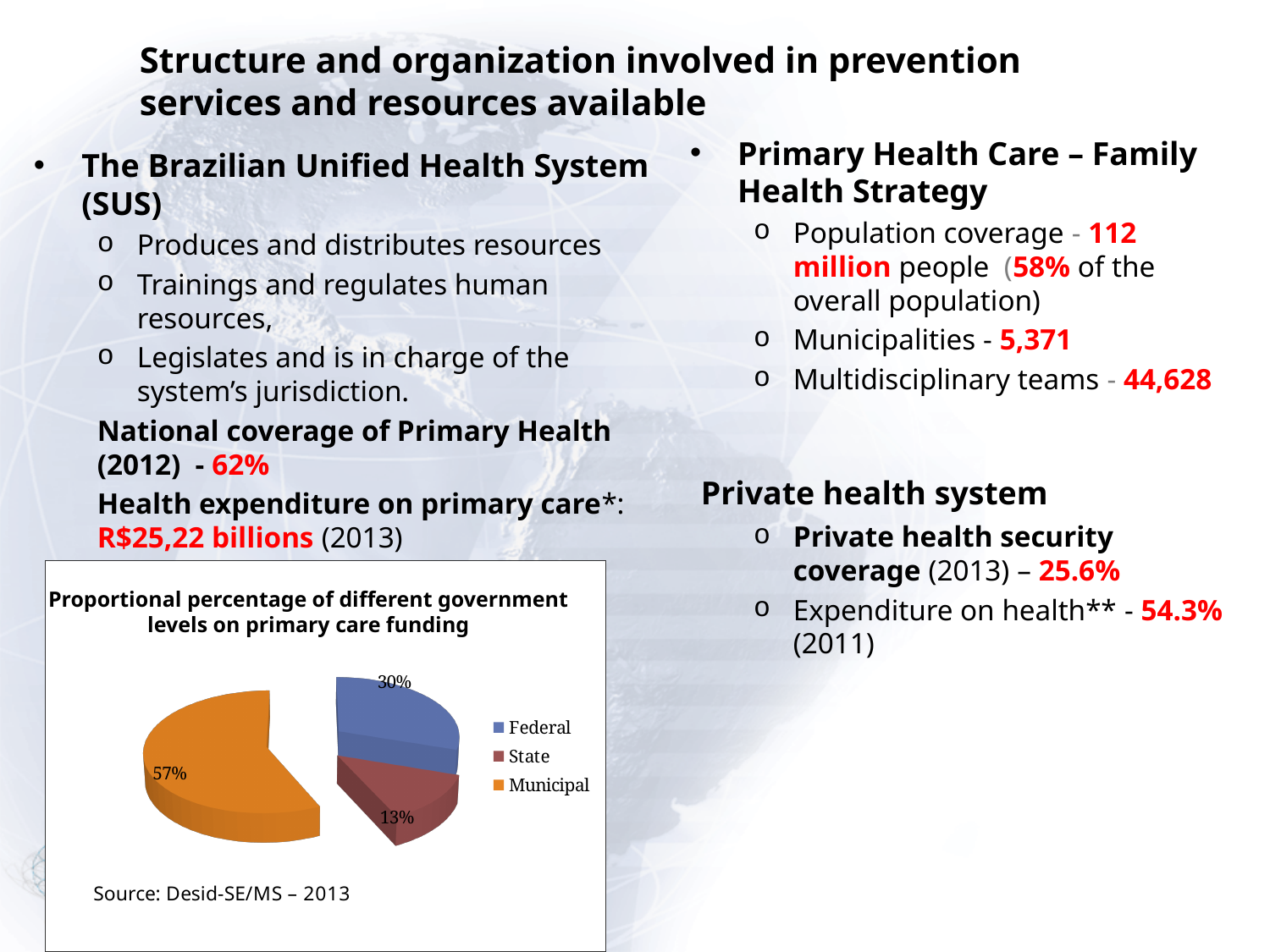
What type of chart is shown on the slide? pie chart What percentage of primary care funding comes from the Federal level? 30% Which government level has the smallest share of primary care funding? State Which is larger, the Federal share or the State share? Federal What is the difference in percentage points between the Federal and State shares? 17 What is the source cited below the chart? Desid-SE/MS – 2013 How many government levels are shown in the pie chart? 3 Which government level has the largest share of primary care funding? Municipal What percentage of primary care funding comes from the State level? 13% What is the difference in percentage points between the Municipal and Federal shares? 27 What is the title of the chart? Proportional percentage of different government levels on primary care funding What percentage of primary care funding comes from the Municipal level? 57%